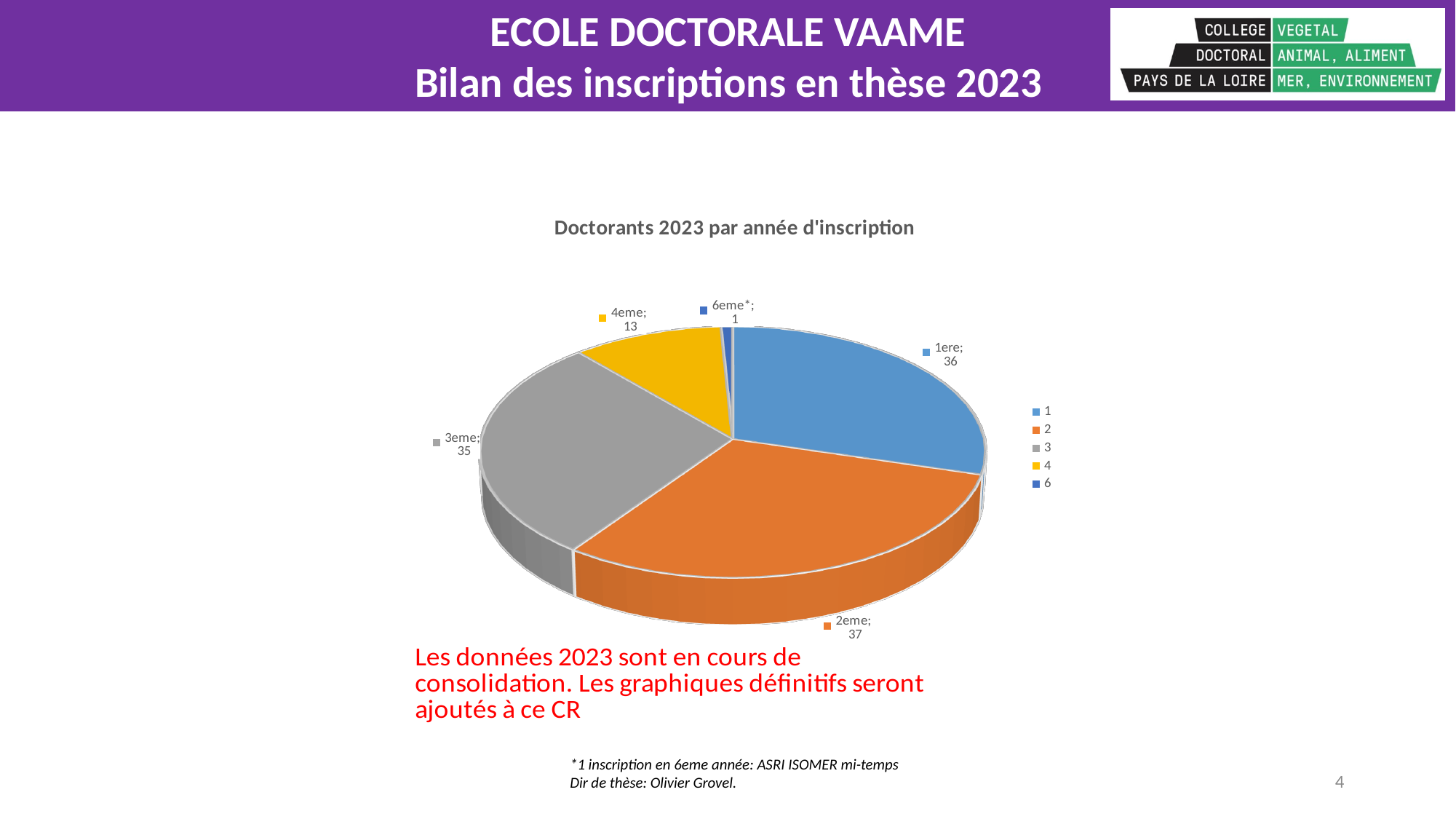
How many entries does the legend list? 5 What is the title of the chart? Doctorants 2023 par année d'inscription What is the value shown for the 4eme slice? 13 Which year of registration has the largest number of doctoral students? 2eme Which year of registration has the smallest number of doctoral students? 6eme* What kind of chart is shown on the slide? pie chart Which is larger, the 3eme slice or the 4eme slice? 3eme What is the value shown for the 6eme* slice? 1 What is the difference between the 1ere and 4eme values? 23 What is the value shown for the 2eme slice? 37 How many slices does the pie chart have? 5 How many doctoral students are in their 1ere year of registration? 36